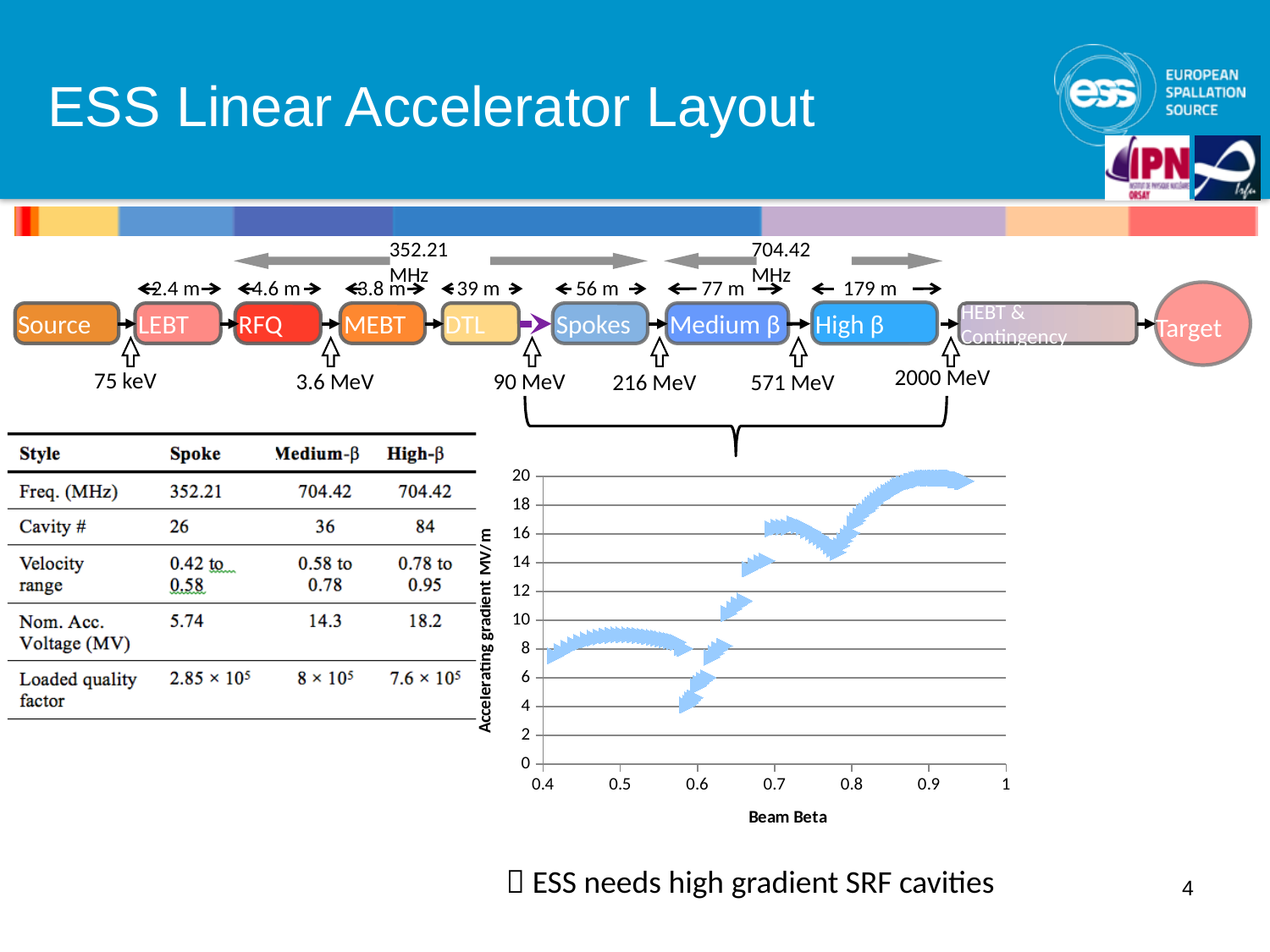
Is the lowest plotted accelerating gradient greater or less than 6? less Is the accelerating gradient at a beam beta of 0.9 greater or less than that at a beam beta of 0.5? greater Is the accelerating gradient at a beam beta of 0.6 greater or less than 10? less Is the accelerating gradient at a beam beta of 0.5 greater or less than 10? less What kind of chart is shown on the slide? scatter chart What is the title of the y axis of the chart? Accelerating gradient MV/m Overall, does the accelerating gradient rise or fall as beam beta increases from 0.4 to 1? rise What is the title of the x axis of the chart? Beam Beta